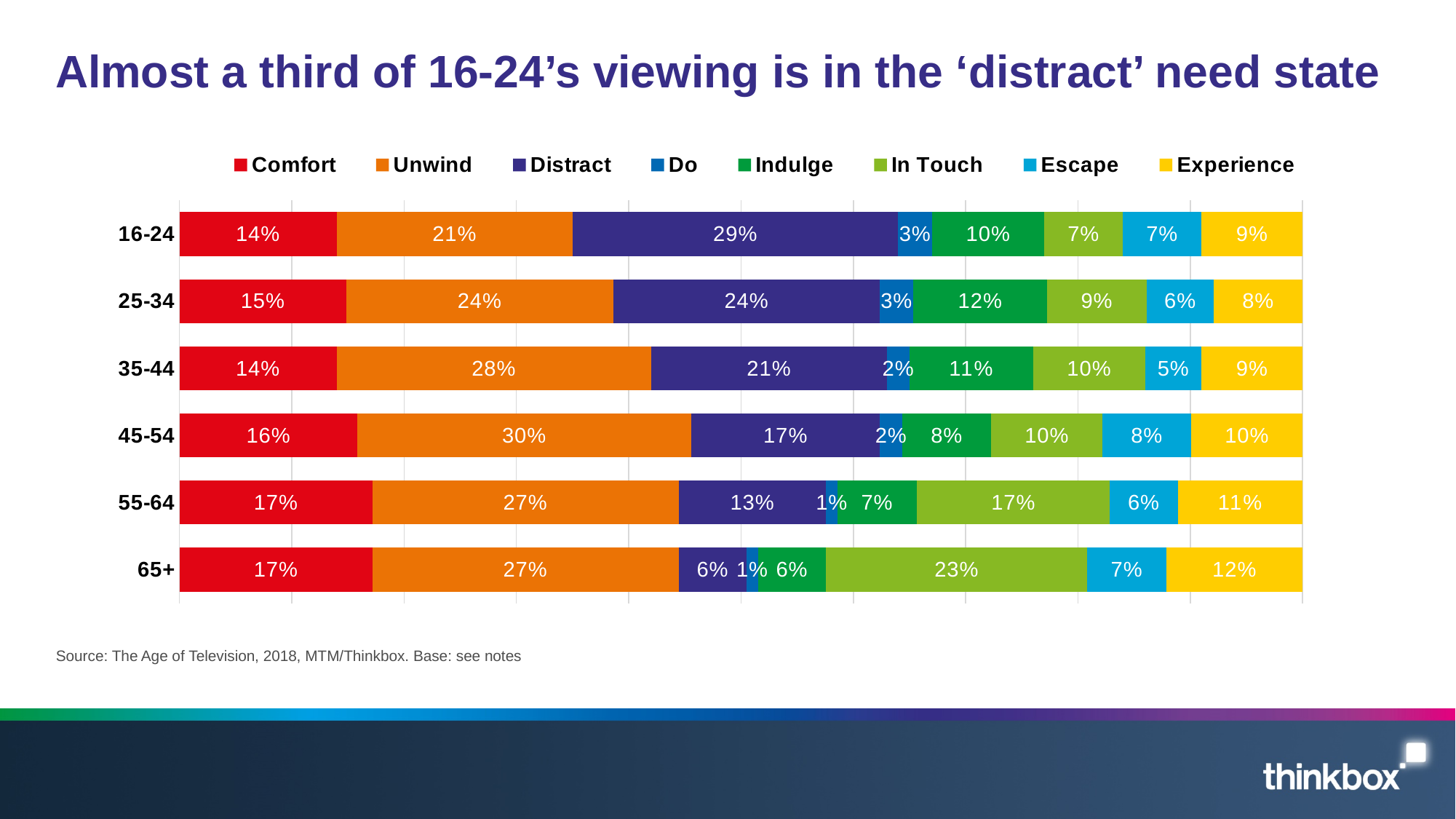
What is the Unwind value for the 45-54 age group? 30% What is the Distract value for the 16-24 age group? 29% Which age group has the lowest Distract value? 65+ How many series does the legend list? 8 What is the In Touch value for the 65+ age group? 23% How many age groups are shown on the chart? 6 Which series is shown in red in the legend? Comfort What is the difference between the Distract value for 16-24 and the Distract value for 65+? 23 percentage points What kind of chart is shown on the slide? Stacked bar chart Which is larger: the Unwind value for 35-44 or the Unwind value for 25-34? Unwind for 35-44 (28%) Does the Distract value rise or fall as the age groups go from 16-24 to 65+? Fall Which age group has the highest Distract value? 16-24